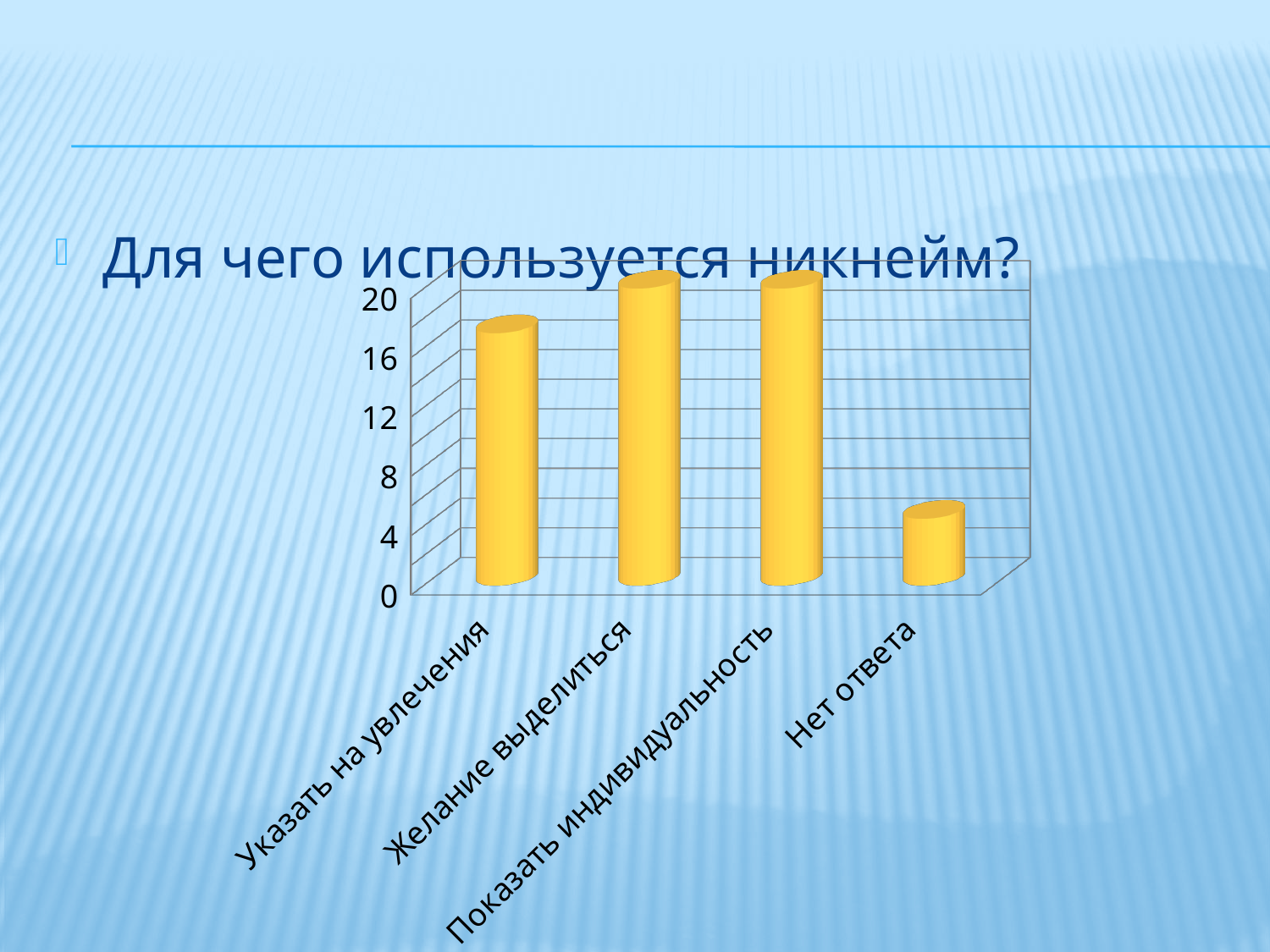
Which is larger, the value for "Указать на увлечения" or the value for "Нет ответа"? Указать на увлечения Is the value for "Показать индивидуальность" greater or less than 16? greater What is the highest tick value shown on the vertical axis of the chart? 20 Is the value for "Нет ответа" greater or less than 8? less Is the value for "Желание выделиться" greater or less than 16? greater What question does the slide title pose above the chart? Для чего используется никнейм? Which category has the lowest value in the chart? Нет ответа What kind of chart is shown on the slide? bar chart How many categories are shown on the x axis of the chart? 4 Which is larger, the value for "Желание выделиться" or the value for "Указать на увлечения"? Желание выделиться